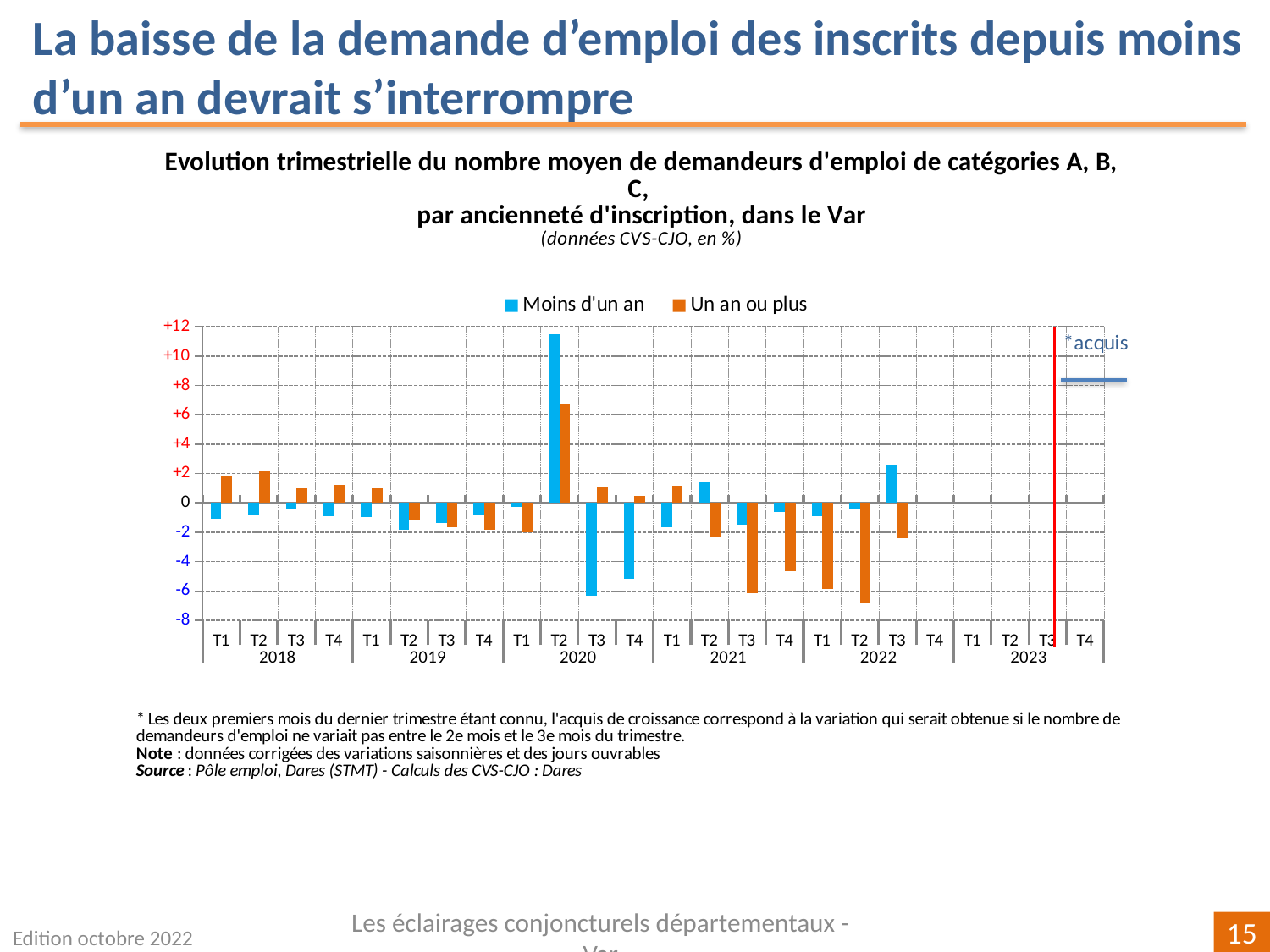
Is the value for 'Un an ou plus' in T2 2020 greater or less than +4? greater What are the two series named in the legend? Moins d'un an; Un an ou plus Is the value for 'Moins d'un an' in T2 2020 greater or less than +10? greater Is the value for 'Un an ou plus' in T2 2022 greater or less than -4? less How many series does the legend list? 2 In which quarter does the 'Un an ou plus' series reach its highest value? T2 2020 In T3 2022, which series has the larger value, 'Moins d'un an' or 'Un an ou plus'? Moins d'un an In which quarter does the 'Moins d'un an' series reach its lowest value? T3 2020 What kind of chart is shown on the slide? bar chart In which quarter does the 'Moins d'un an' series reach its highest value? T2 2020 In T2 2020, which series has the larger value, 'Moins d'un an' or 'Un an ou plus'? Moins d'un an